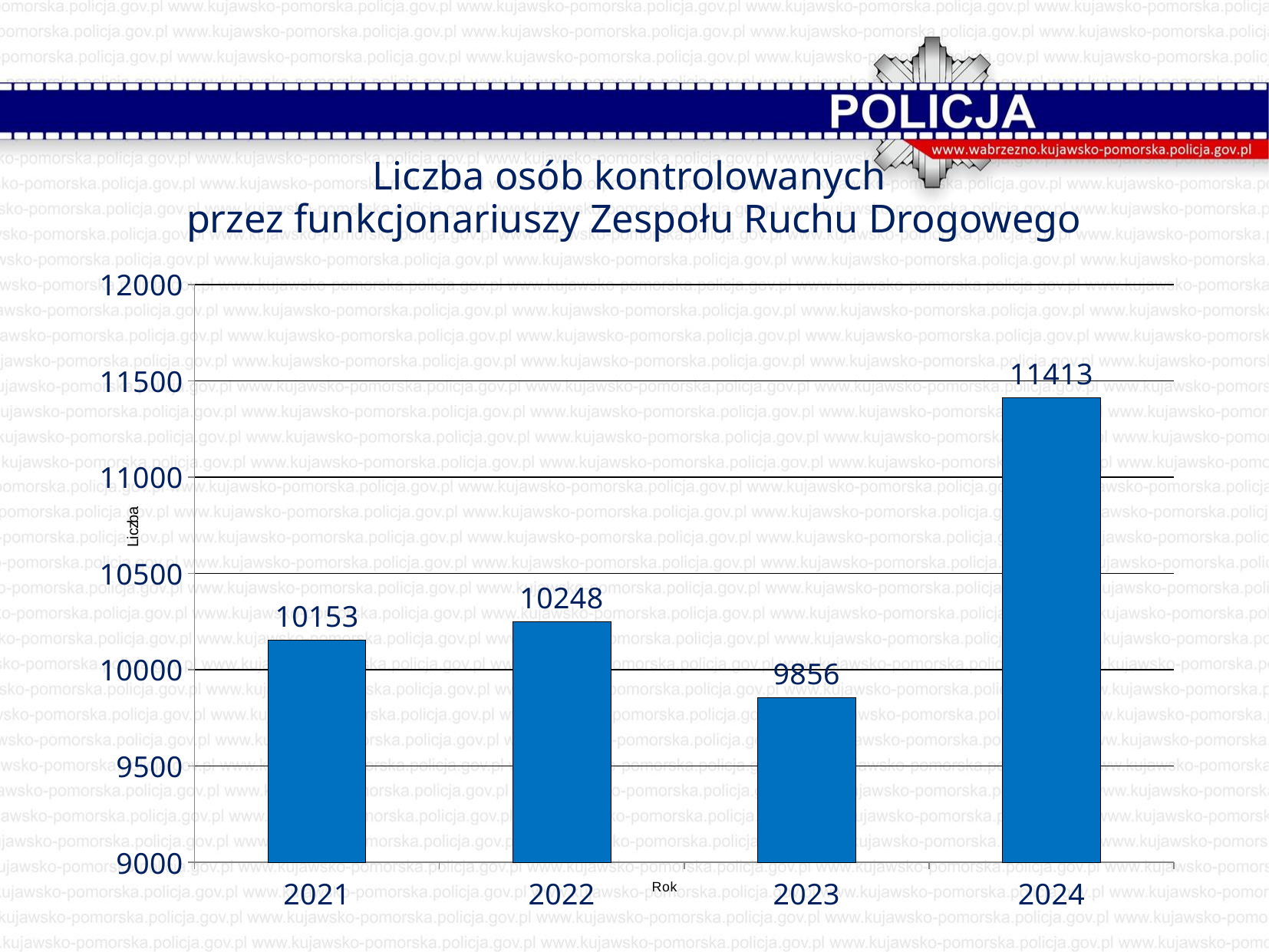
Is the value for 2023 greater or less than 10000? less Which year has the highest value? 2024 What is the value for 2024? 11413 What is the difference between the values for 2024 and 2023? 1557 What is the value for 2021? 10153 What kind of chart is shown on the slide? bar chart Which is larger, the value for 2021 or the value for 2023? 2021 What is the difference between the values for 2022 and 2021? 95 What is the value for 2022? 10248 What is the value for 2023? 9856 How many years are shown on the x axis? 4 Which year has the lowest value? 2023